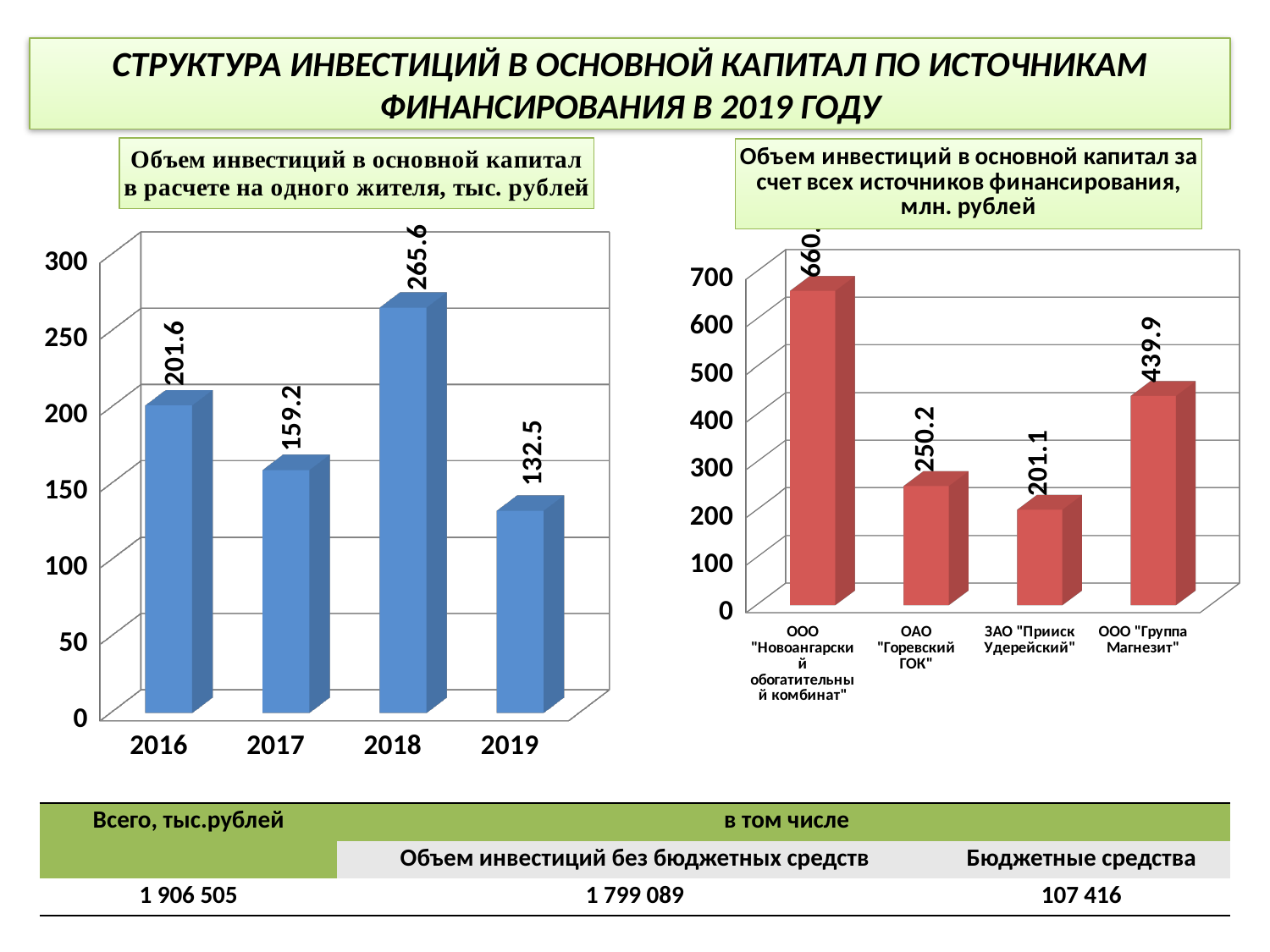
In the left chart (investment per resident, thousand rubles), what is the value for 2019? 132.5 In the right chart (investment from all sources), is the value for ООО "Новоангарский обогатительный комбинат" greater or less than 600? greater In the left chart (investment per resident), what is the difference between the 2016 and 2017 values? 42.4 In the right chart (investment from all sources), which is larger: ООО "Группа Магнезит" or ОАО "Горевский ГОК"? ООО "Группа Магнезит" In the left chart (investment per resident), which year has the lowest value? 2019 In the right chart (investment from all sources, million rubles), what is the value for ООО "Группа Магнезит"? 439.9 In the left chart (investment per resident), which year has the highest value? 2018 In the left chart (investment per resident, thousand rubles), what is the value for 2018? 265.6 In the right chart (investment from all sources, million rubles), what is the value for ОАО "Горевский ГОК"? 250.2 What type of chart is the left chart (investment per resident)? Bar chart In the left chart (investment per resident), how many years are shown? 4 In the right chart (investment from all sources), which company has the lowest value? ЗАО "Прииск Удерейский"